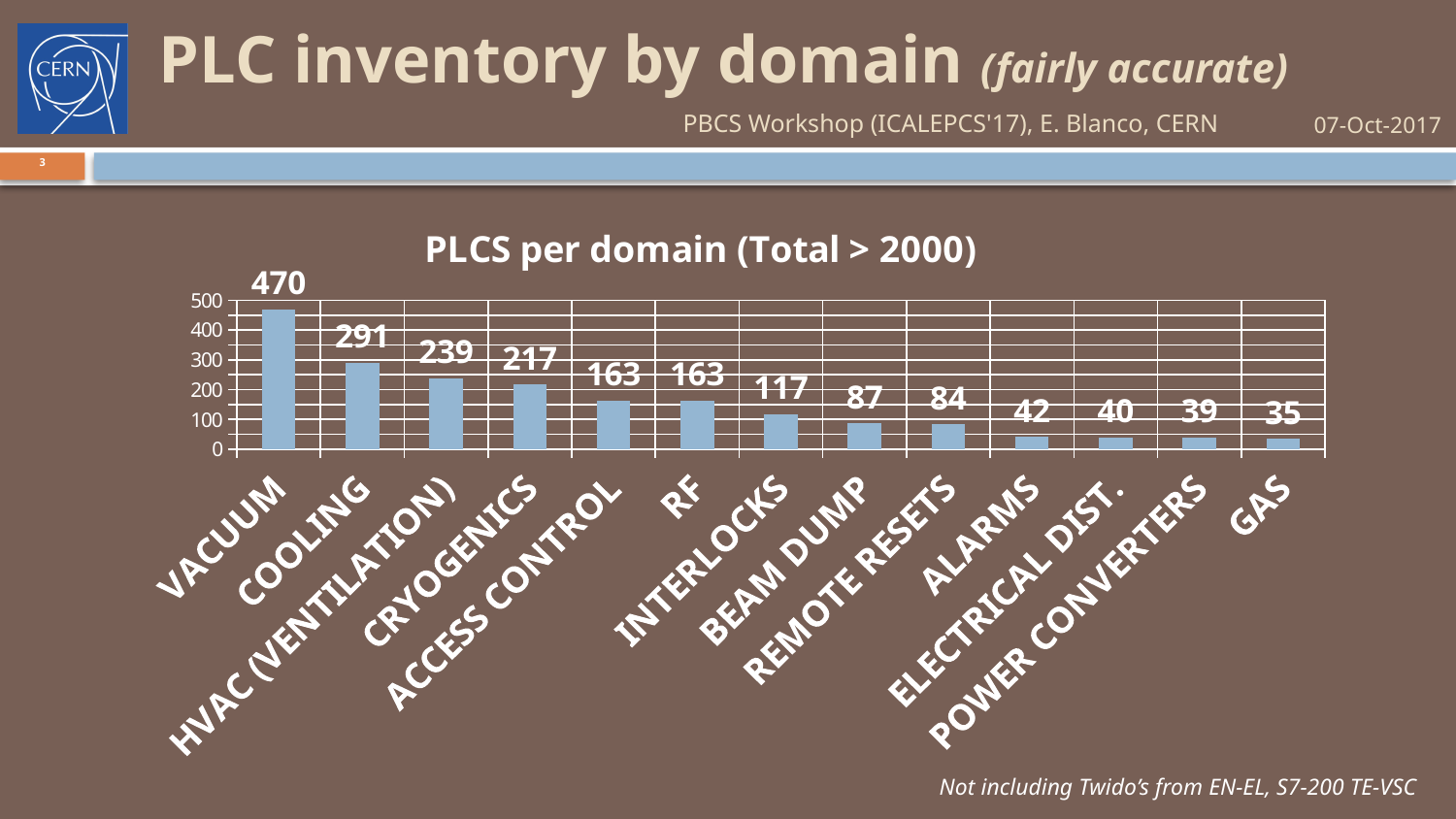
What is the title of the chart? PLCS per domain (Total > 2000) Which domain has the highest number of PLCs? VACUUM What is the value for ELECTRICAL DIST.? 40 What kind of chart is shown? bar chart Which is larger, the value for INTERLOCKS or the value for ALARMS? INTERLOCKS Do the values rise or fall from left to right along the x axis? fall What is the value for CRYOGENICS? 217 How many domains are shown on the chart? 13 What is the value for VACUUM? 470 What is the difference between the values for VACUUM and COOLING? 179 What is the value for BEAM DUMP? 87 Which domain has the lowest number of PLCs? GAS